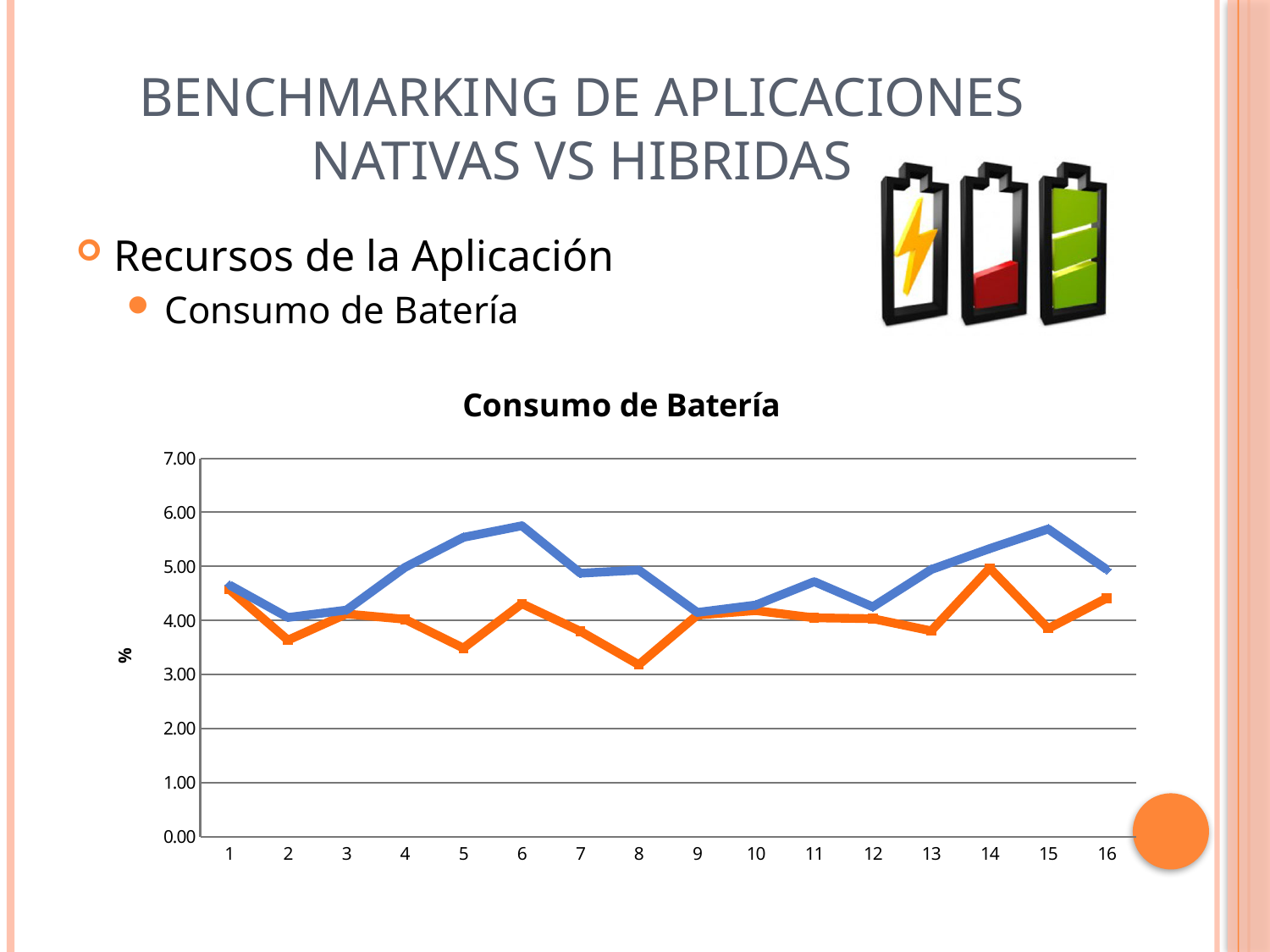
At which x-axis point does the orange line reach its lowest value? 8 What is the title of the chart? Consumo de Batería How many points are plotted along the x axis for each line? 16 How many lines are plotted on the chart? 2 Is the value of the blue line at point 15 greater or less than 5.00? greater Is the value of the orange line at point 8 greater or less than 4.00? less What kind of chart is shown on the slide? line chart What is the label on the vertical axis of the chart? % At point 6, which line has the higher value, the blue line or the orange line? the blue line Is the value of the blue line at point 6 greater or less than 5.00? greater At which x-axis point does the orange line reach its highest value? 14